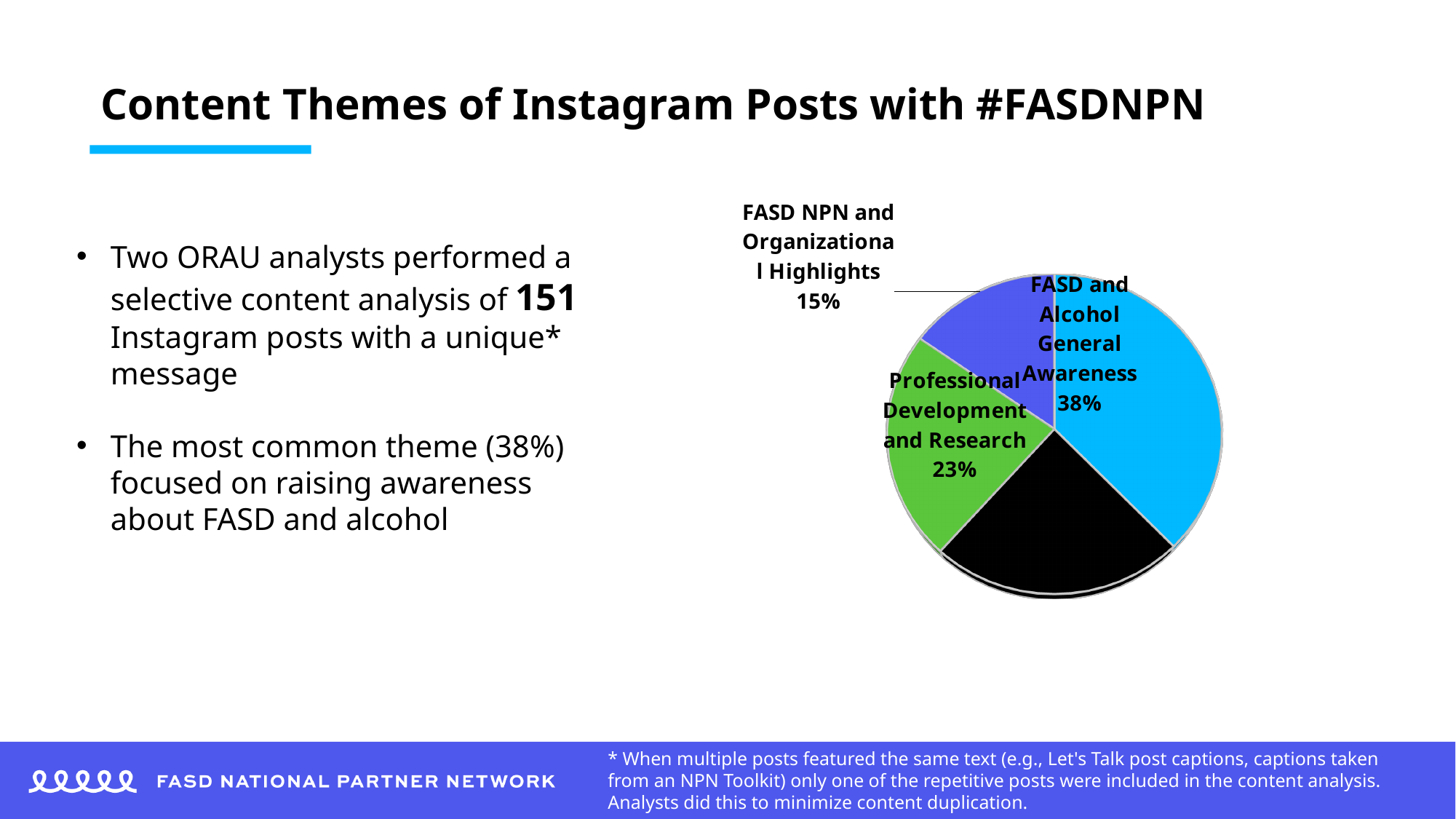
What share of the pie does FASD NPN and Organizational Highlights represent? 15% Which is larger: the share for Professional Development and Research or the share for FASD NPN and Organizational Highlights? Professional Development and Research How many percentage points larger is the FASD and Alcohol General Awareness share than the Professional Development and Research share? 15 What share of the pie does Professional Development and Research represent? 23% What colour is the slice for Professional Development and Research? green What kind of chart is shown on the slide? pie chart How many percentage points larger is the Professional Development and Research share than the FASD NPN and Organizational Highlights share? 8 What share of the pie does FASD and Alcohol General Awareness represent? 38% Which labeled theme has the largest share of the pie? FASD and Alcohol General Awareness Which labeled theme has the smallest share of the pie? FASD NPN and Organizational Highlights What colour is the slice for FASD and Alcohol General Awareness? light blue How many slices does the pie chart have? 4